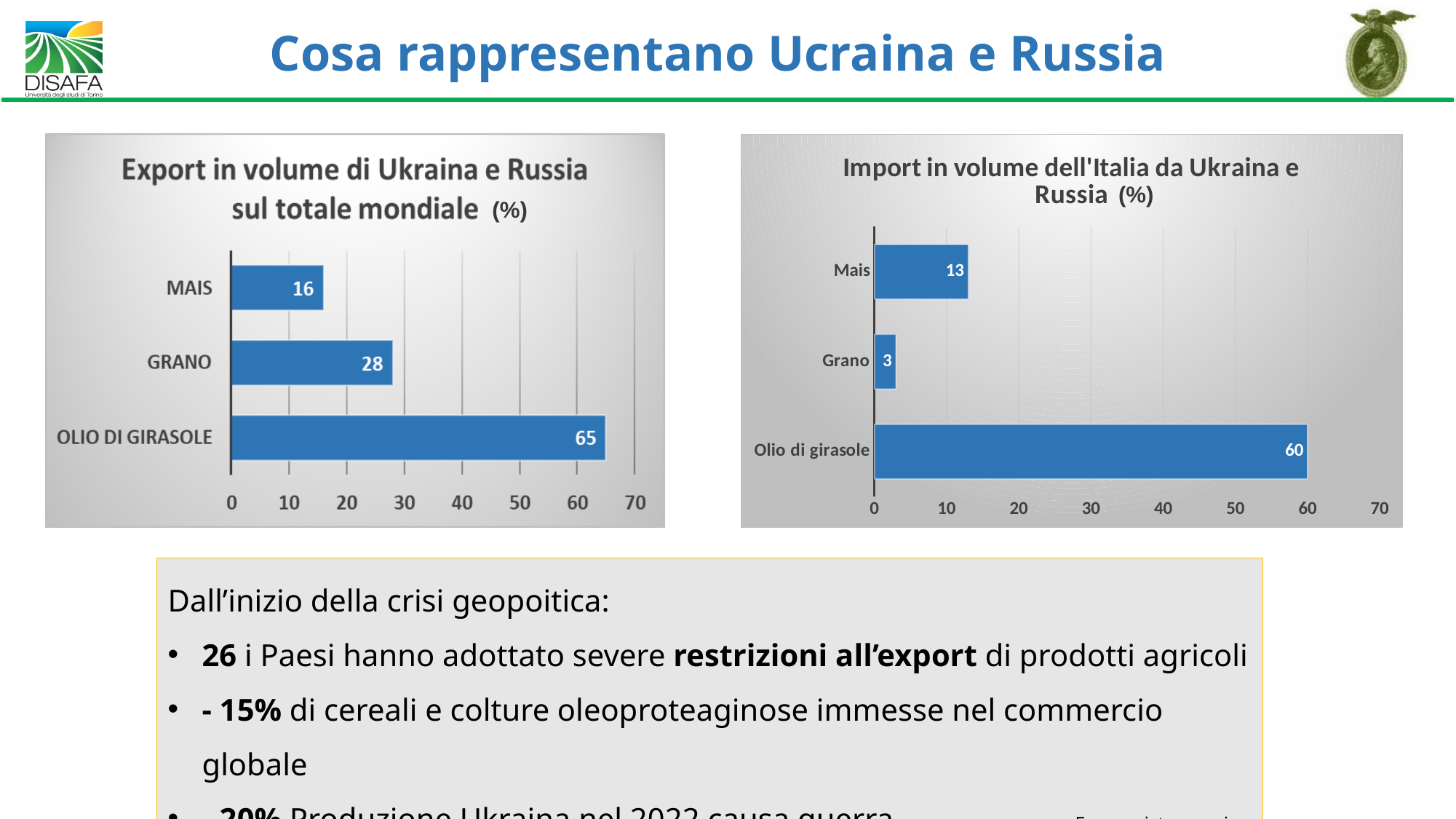
What is the title of the left chart? Export in volume di Ukraina e Russia sul totale mondiale (%) In the right chart 'Import in volume dell'Italia da Ukraina e Russia (%)', what is the value for Mais? 13 What kind of chart is the right chart 'Import in volume dell'Italia da Ukraina e Russia (%)'? Bar chart In the left chart 'Export in volume di Ukraina e Russia sul totale mondiale (%)', what is the difference between OLIO DI GIRASOLE and GRANO? 37 In the right chart 'Import in volume dell'Italia da Ukraina e Russia (%)', which is larger, Mais or Grano? Mais How many categories are shown in the left chart 'Export in volume di Ukraina e Russia sul totale mondiale (%)'? 3 In the left chart 'Export in volume di Ukraina e Russia sul totale mondiale (%)', which category has the highest value? OLIO DI GIRASOLE In the right chart 'Import in volume dell'Italia da Ukraina e Russia (%)', what is the value for Olio di girasole? 60 In the right chart 'Import in volume dell'Italia da Ukraina e Russia (%)', which category has the lowest value? Grano In the left chart 'Export in volume di Ukraina e Russia sul totale mondiale (%)', what is the value for GRANO? 28 In the right chart 'Import in volume dell'Italia da Ukraina e Russia (%)', what is the difference between Mais and Grano? 10 In the left chart 'Export in volume di Ukraina e Russia sul totale mondiale (%)', what is the value for MAIS? 16